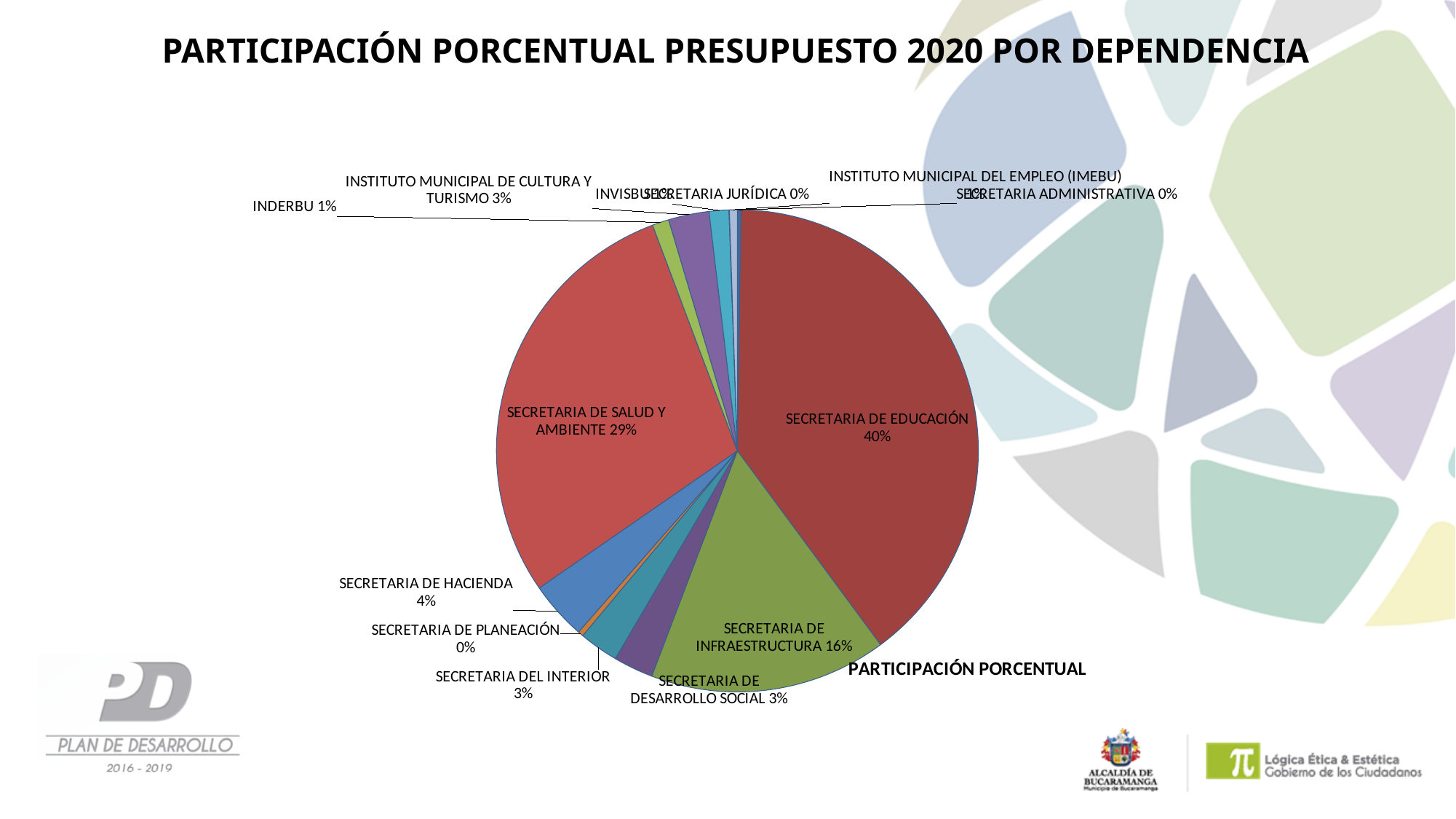
What is the value shown for INDERBU? 1% What kind of chart is shown on the slide? pie chart Which dependency has the largest slice of the pie? SECRETARIA DE EDUCACIÓN What is the value shown for SECRETARIA DE INFRAESTRUCTURA? 16% What share of the pie does SECRETARIA DE EDUCACIÓN hold? 40% Which is larger, the share of SECRETARIA DE INFRAESTRUCTURA or SECRETARIA DE HACIENDA? SECRETARIA DE INFRAESTRUCTURA What is the combined share of SECRETARIA DE EDUCACIÓN and SECRETARIA DE INFRAESTRUCTURA? 56% What is the value shown for INSTITUTO MUNICIPAL DE CULTURA Y TURISMO? 3% What is the value shown for SECRETARIA DE SALUD Y AMBIENTE? 29% What is the title of the slide's chart? PARTICIPACIÓN PORCENTUAL What is the value shown for SECRETARIA DE HACIENDA? 4% What is the difference between the shares of SECRETARIA DE EDUCACIÓN and SECRETARIA DE SALUD Y AMBIENTE? 11%